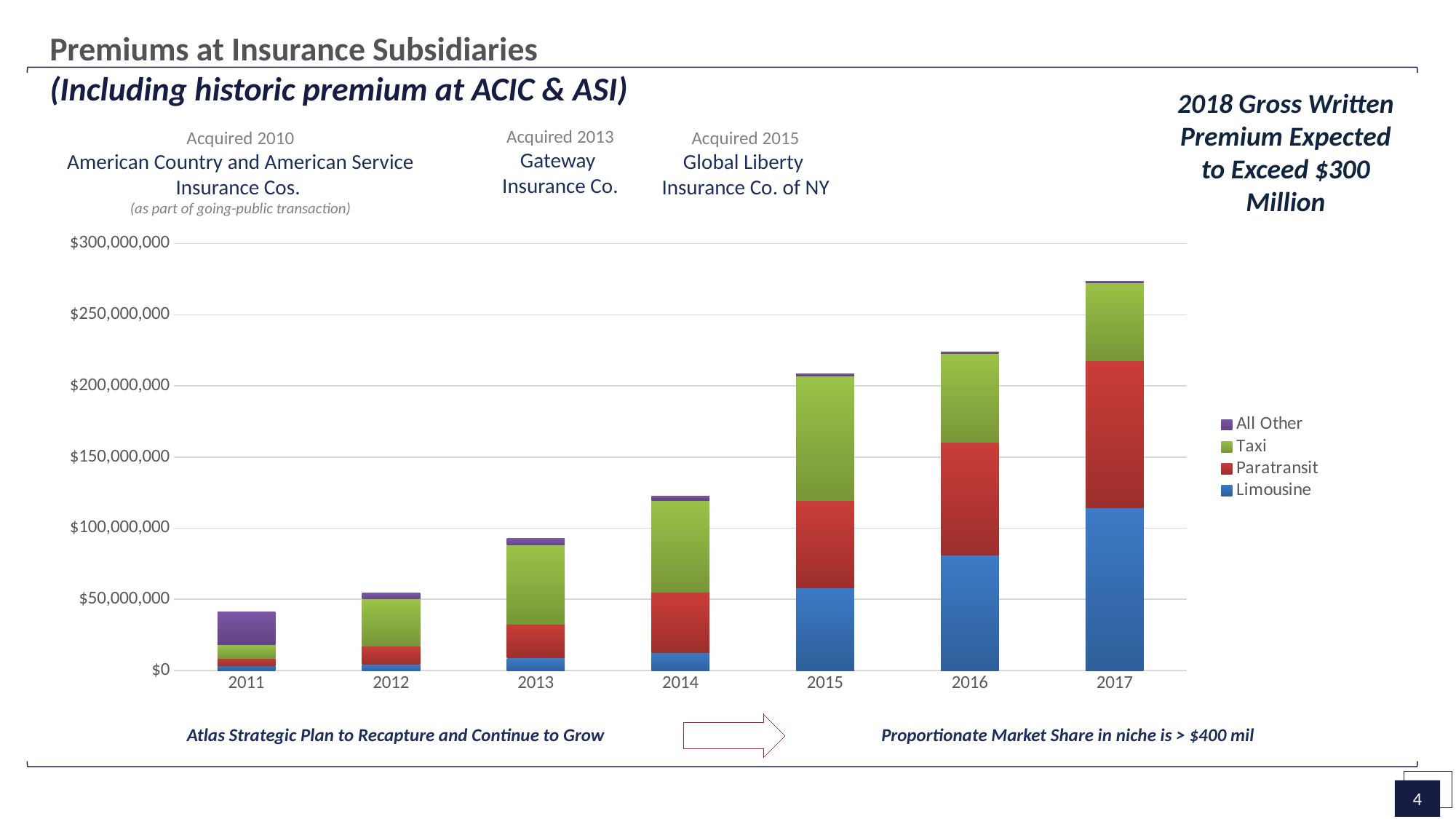
Is the total premium bar for 2011 greater or less than $50,000,000? less Which year has the lowest total premium bar? 2011 Is the total premium bar for 2014 greater or less than $100,000,000? greater Which series is shown in blue in the chart legend? Limousine Is the Limousine segment for 2017 greater or less than $100,000,000? greater What kind of chart is shown on the slide? Stacked bar chart Do the total premiums rise or fall from 2011 to 2017? Rise How many years are shown on the x axis of the chart? 7 Which year has the highest total premium bar? 2017 How many series does the chart legend list? 4 Which year has the larger total premium bar, 2015 or 2016? 2016